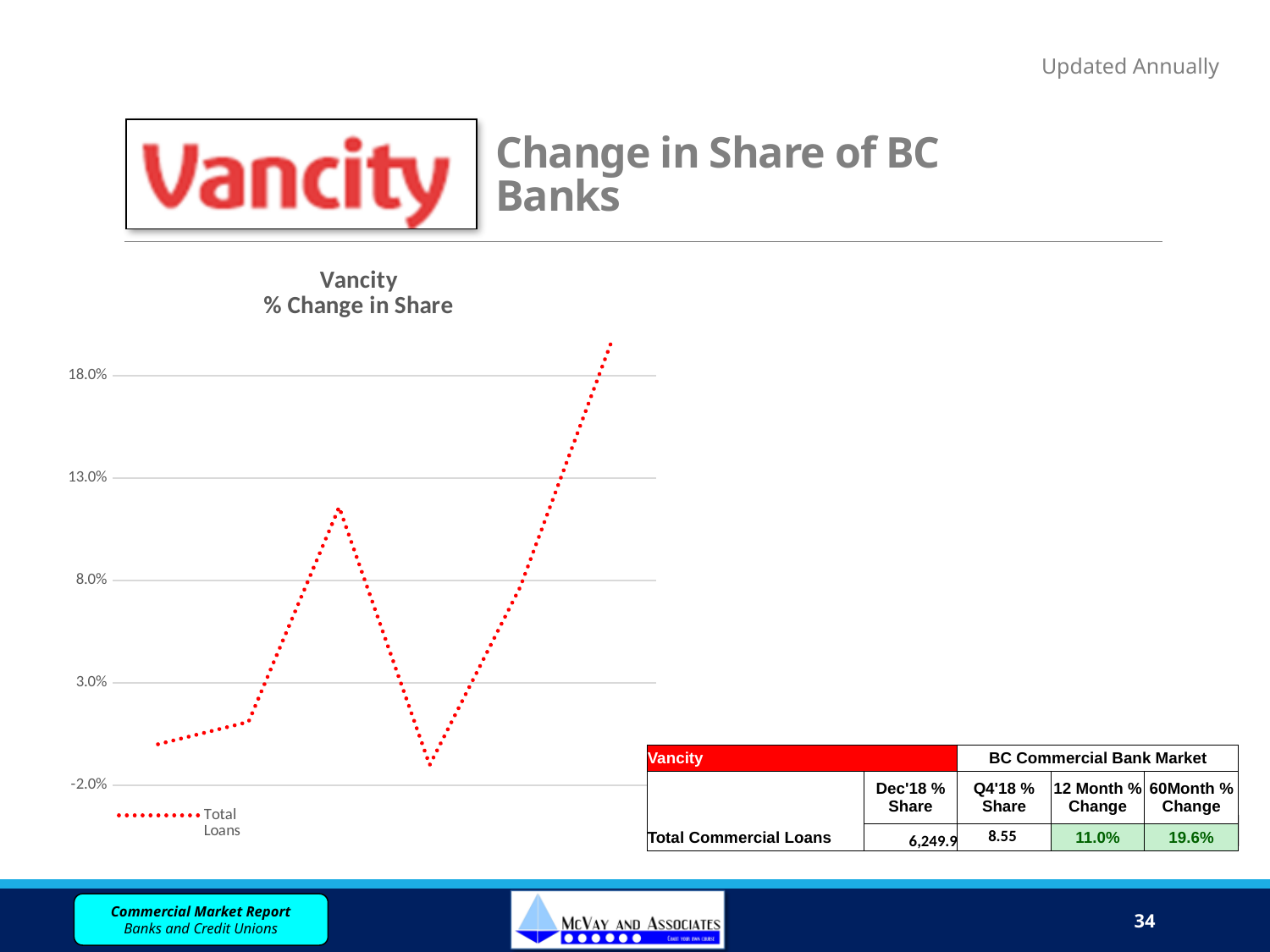
Does the Total Loans line end higher or lower than it starts? higher Is the first point of the Total Loans line greater or less than 3.0%? less What is the title of the chart? Vancity % Change in Share Is the lowest point of the Total Loans line greater or less than -2.0%? greater What kind of chart is shown on the slide? line chart How many series does the chart's legend list? 1 Is the final point of the Total Loans line greater or less than 18.0%? greater What is the highest value shown on the chart's vertical axis? 18.0% What series name appears in the chart's legend? Total Loans